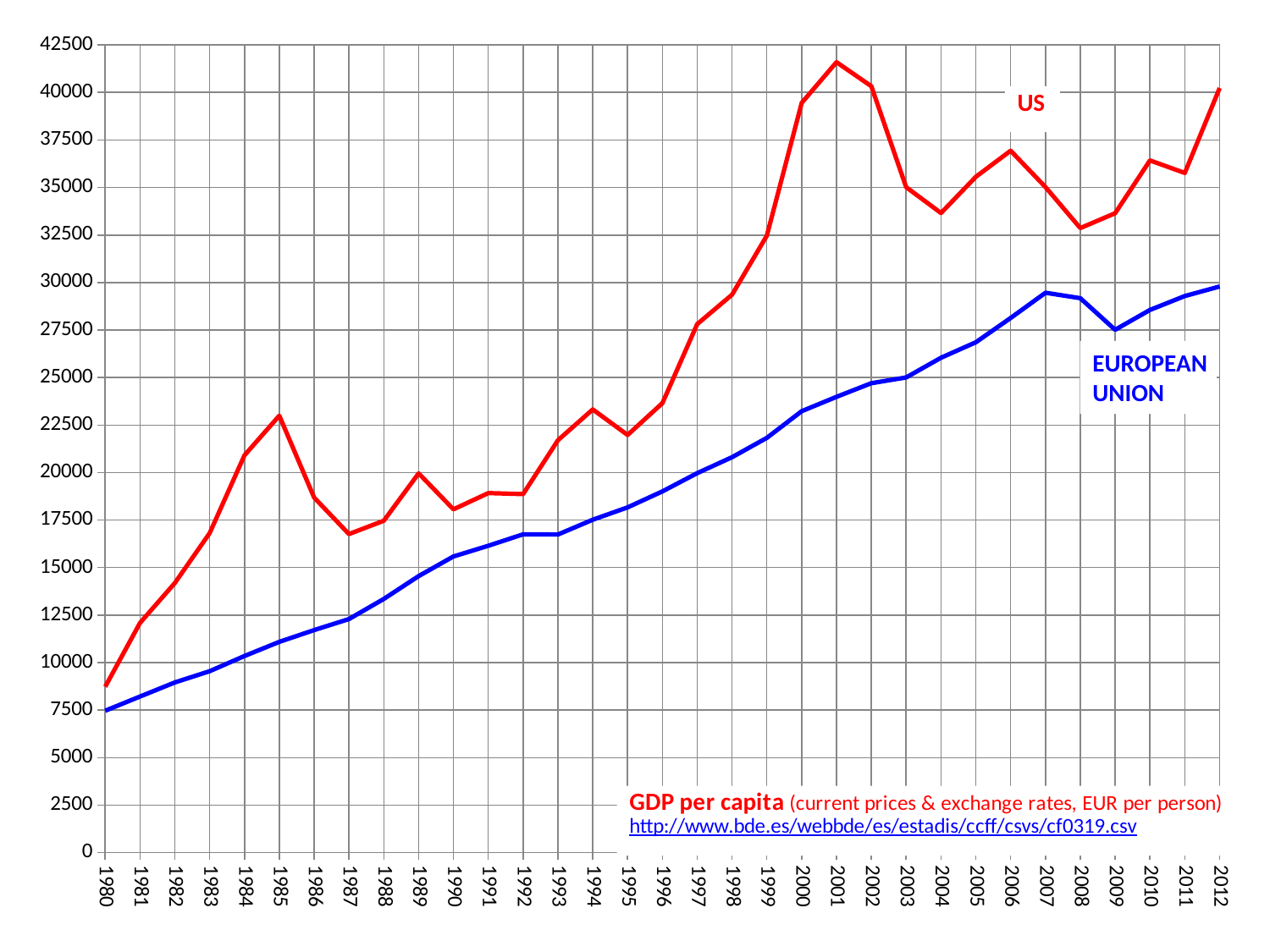
How many years are shown along the x axis of the chart? 33 Is the European Union value for 1980 greater or less than 10000? less In which year is the European Union series at its lowest value? 1980 Is the European Union value for 2012 greater or less than 27500? greater How many data series are plotted on the chart? 2 Is the US value for 2001 greater or less than 40000? greater What kind of chart is shown on the slide? line chart Does the European Union series generally rise or fall from 1980 to 2012? rise In which year does the US series reach its highest value? 2001 In 2000, which series has the higher GDP per capita, US or European Union? US